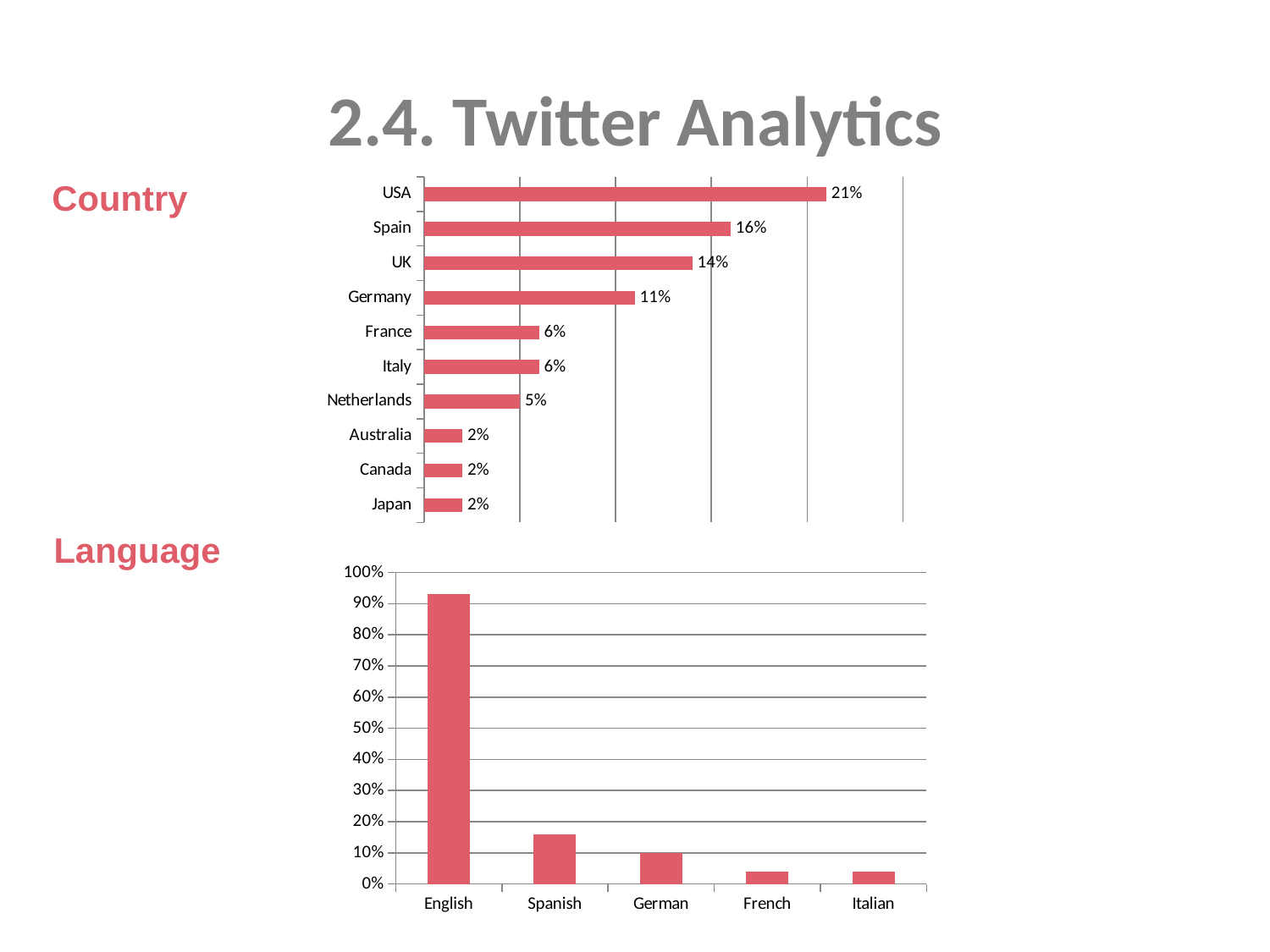
In the Language chart, which language has the highest value? English How many countries are shown in the Country chart? 10 In the Country chart, what is the difference between the values for USA and UK? 7% What kind of chart is the Language chart? Bar chart In the Country chart, what is the value for Germany? 11% In the Country chart, which is larger, the value for Netherlands or the value for France? France In the Country chart, what is the value for Netherlands? 5% In the Country chart, which country has the highest value? USA In the Country chart, what is the value for Spain? 16% In the Language chart, is the value for Spanish greater or less than 20%? less In the Language chart, is the value for English greater or less than 90%? greater How many languages are shown in the Language chart? 5